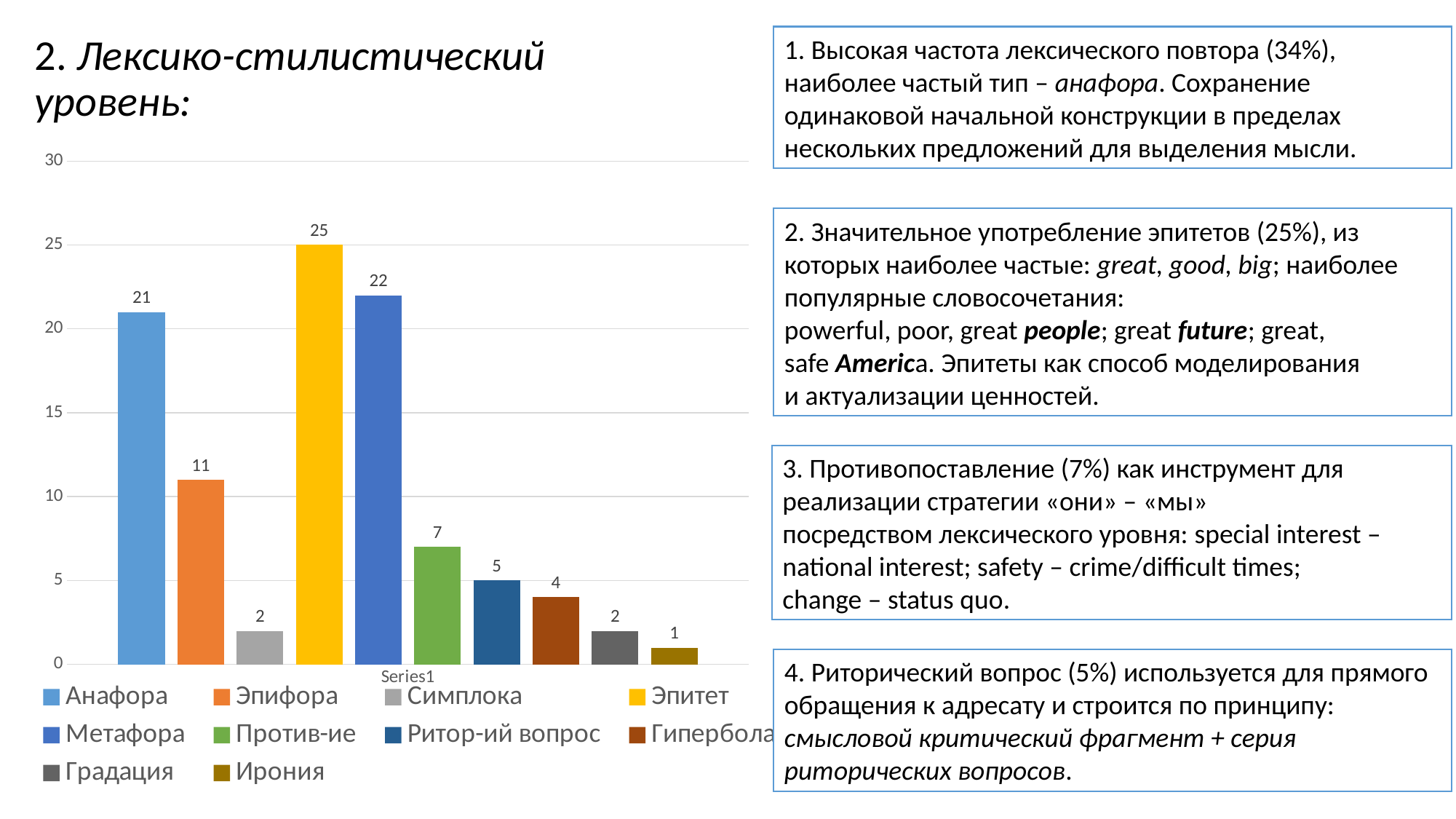
What colour is the bar for Эпитет? yellow How many bars are plotted in the chart? 10 What is the difference between the values for Эпитет and Анафора? 4 What type of chart is shown on the slide? bar chart Which is larger, the value for Эпифора or the value for Против-ие? Эпифора What is the value for Ритор-ий вопрос? 5 What is the value for Анафора? 21 Which category has the lowest value? Ирония How many entries does the legend list? 10 Which category has the highest value? Эпитет What is the value for Метафора? 22 What is the value for Эпитет? 25